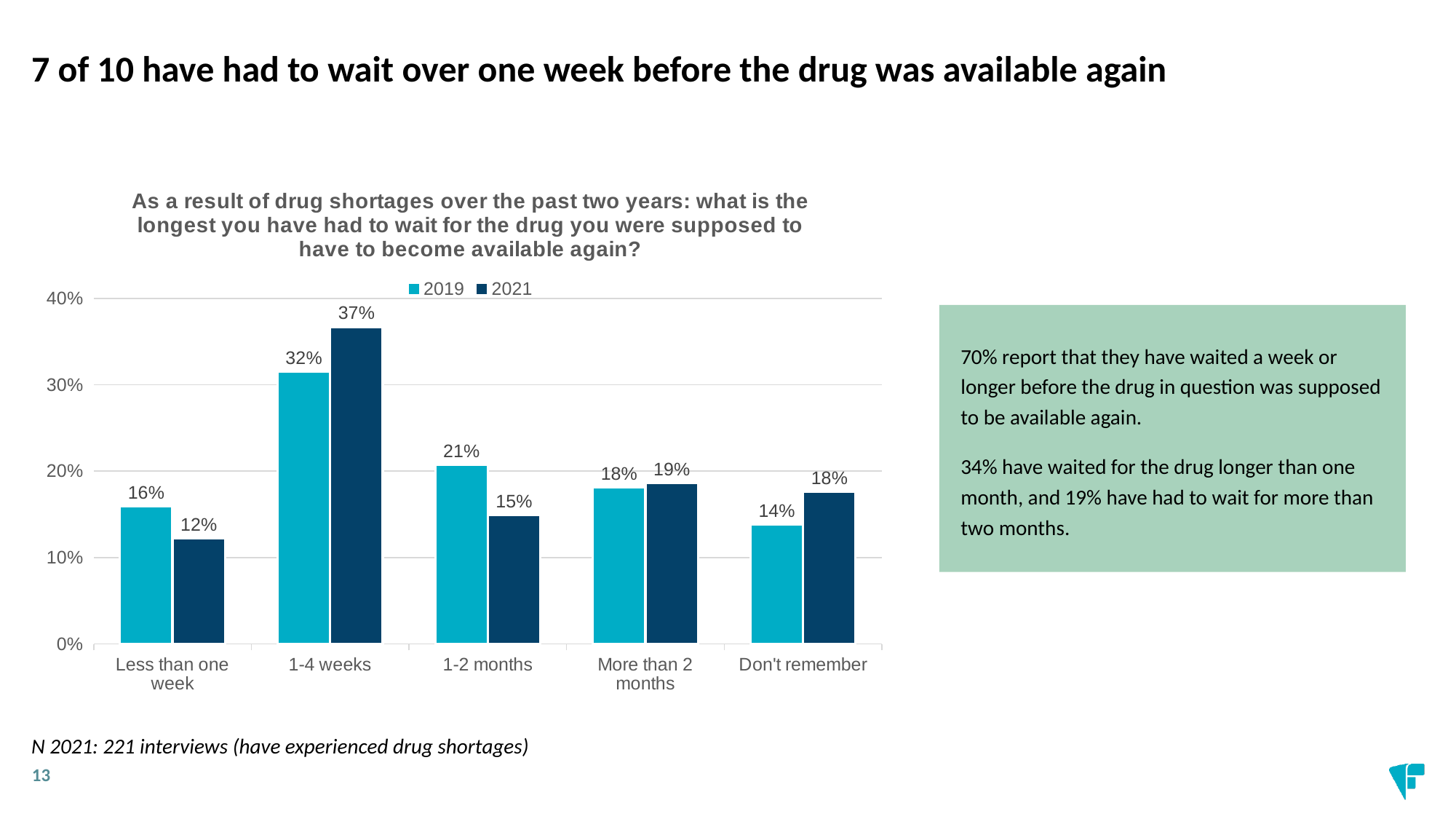
What is the 2021 value for 1-2 months? 15% How many categories are shown on the x axis? 5 What kind of chart is shown on the slide? Bar chart Which series is shown in the darker blue colour? 2021 Which category has the lowest 2021 value? Less than one week What is the 2021 value for 1-4 weeks? 37% Which category has the highest 2021 value? 1-4 weeks What is the 2019 value for Don't remember? 14% Which is larger for Don't remember, the 2019 value or the 2021 value? 2021 What is the difference between the 2019 and 2021 values for 1-2 months? 6% What is the 2019 value for Less than one week? 16% How many series does the legend list? 2